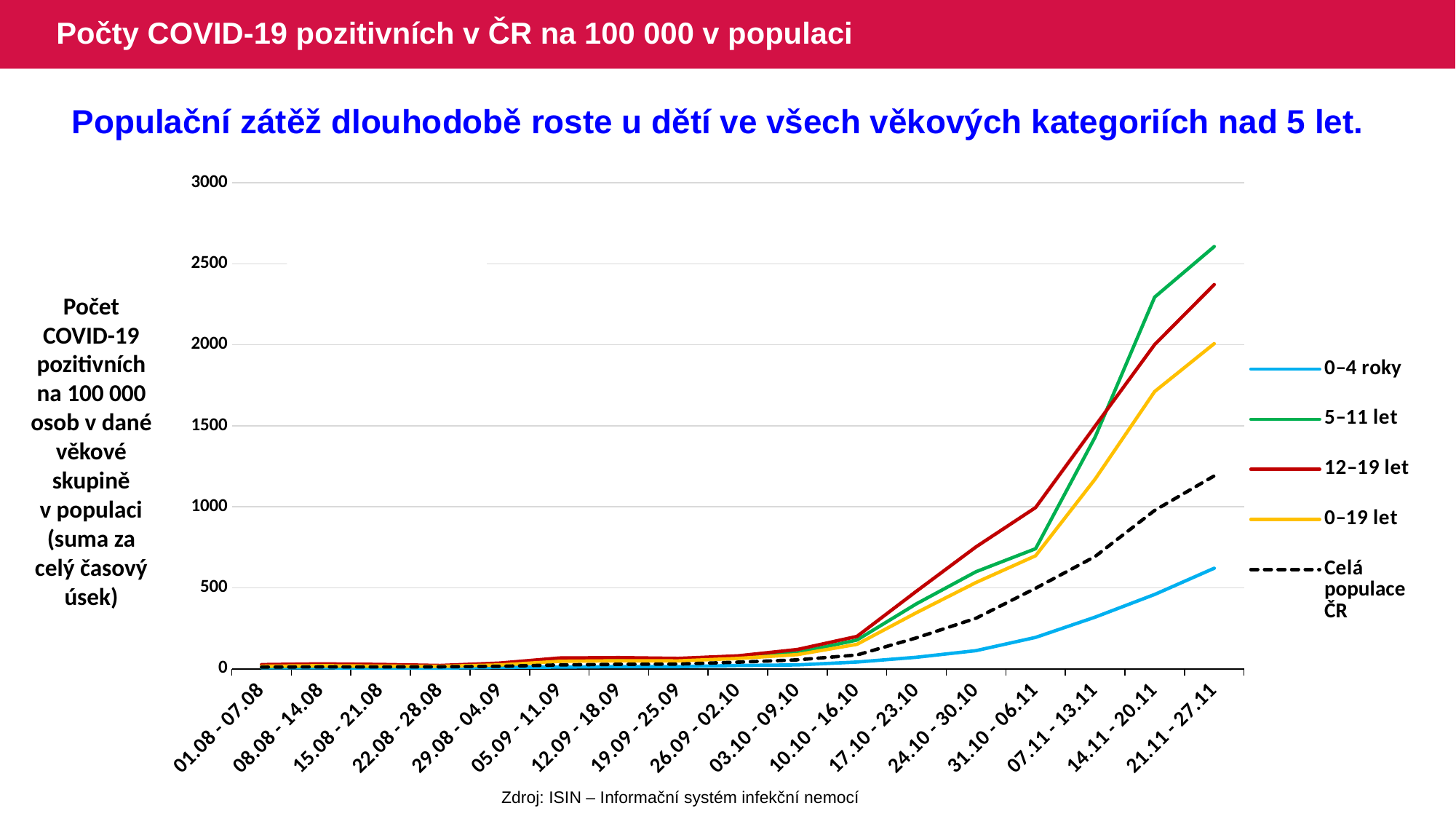
Is the value for 5–11 let in the period 21.11 - 27.11 greater or less than 2500? greater In the period 31.10 - 06.11, which is larger: the value for 12–19 let or for 5–11 let? 12–19 let Which series has the lowest value in the last period, 21.11 - 27.11? 0–4 roky Is the value for 0–4 roky in the period 21.11 - 27.11 greater or less than 500? greater Is the value for Celá populace ČR in the period 21.11 - 27.11 greater or less than 1000? greater What kind of chart is shown on the slide? line chart How many weekly periods are shown on the x axis? 17 Do the values for 12–19 let rise or fall over the periods shown on the x axis? rise How many series does the legend list? 5 Which series has the highest value in the last period, 21.11 - 27.11? 5–11 let Which series is drawn with a dashed black line? Celá populace ČR